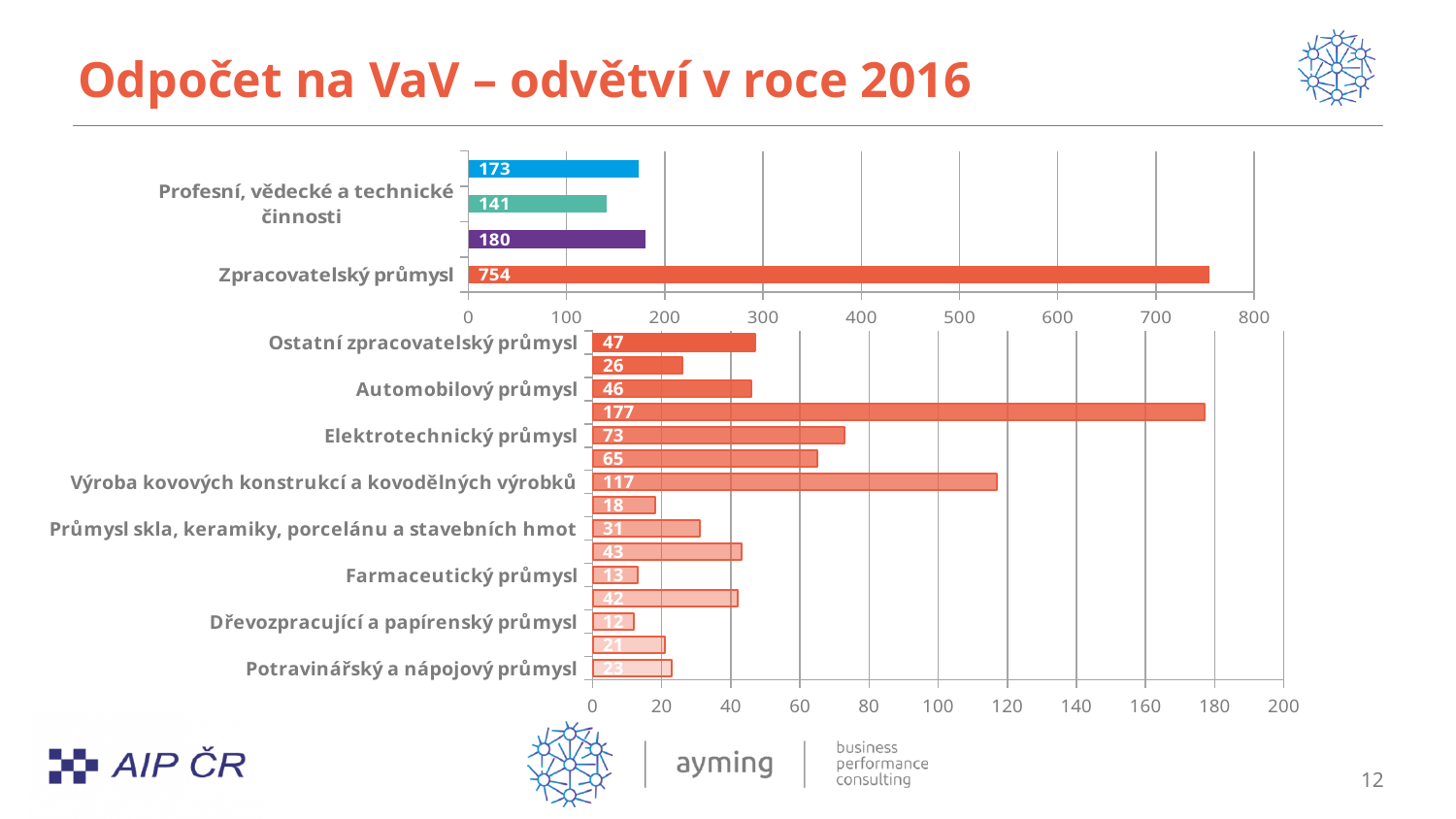
In the bottom chart, what is the value for Výroba kovových konstrukcí a kovodělných výrobků? 117 In the bottom chart, which is larger: the value for Ostatní zpracovatelský průmysl or for Potravinářský a nápojový průmysl? Ostatní zpracovatelský průmysl In the bottom chart, what is the difference between the values for Elektrotechnický průmysl and Automobilový průmysl? 27 In the bottom chart, what is the largest value shown on any bar? 177 What kind of chart is the top chart on the slide? Bar chart What is the title of the slide? Odpočet na VaV – odvětví v roce 2016 In the bottom chart, what is the value for Elektrotechnický průmysl? 73 In the top chart, what is the value for Zpracovatelský průmysl? 754 How many bars are plotted in the top chart? 4 In the bottom chart, what is the value for Farmaceutický průmysl? 13 In the bottom chart, is the value for Výroba kovových konstrukcí a kovodělných výrobků greater or less than 100? greater In the top chart, which category has the longest bar? Zpracovatelský průmysl